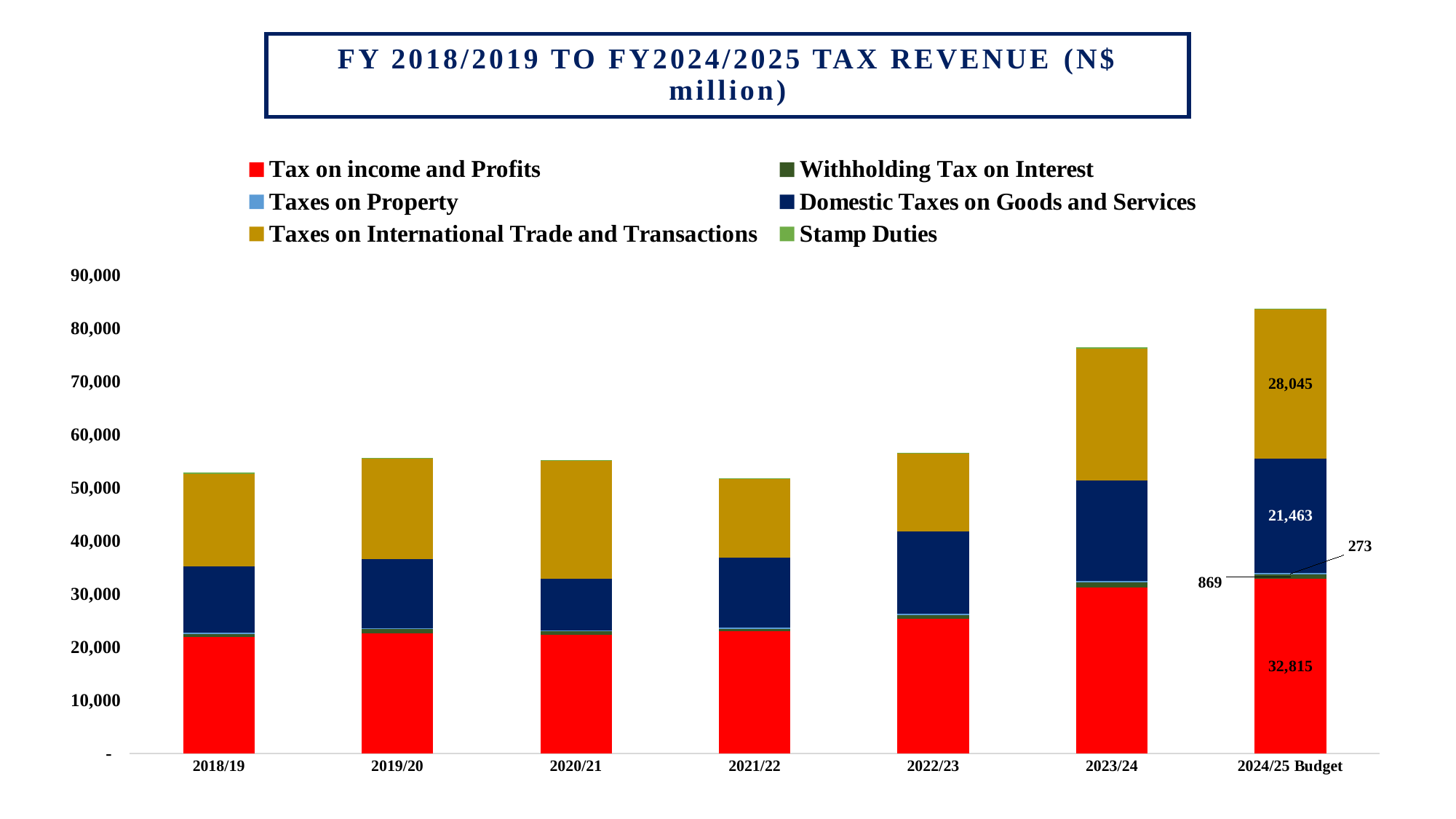
In 2024/25 Budget, what is the difference between Taxes on International Trade and Transactions and Domestic Taxes on Goods and Services? 6,582 What is the value for Domestic Taxes on Goods and Services in 2024/25 Budget? 21,463 What kind of chart is shown on the slide? Stacked bar chart How many series does the legend list? 6 How many fiscal years (categories) are shown on the x axis? 7 Which total bar is taller, 2022/23 or 2023/24? 2023/24 What is the value for Taxes on International Trade and Transactions in 2024/25 Budget? 28,045 Is the total bar for 2023/24 greater or less than 70,000? greater Which fiscal year has the tallest total bar? 2024/25 Budget Which series is shown in red in the legend? Tax on income and Profits What is the value for Tax on income and Profits in 2024/25 Budget? 32,815 Is the total bar for 2021/22 greater or less than 60,000? less